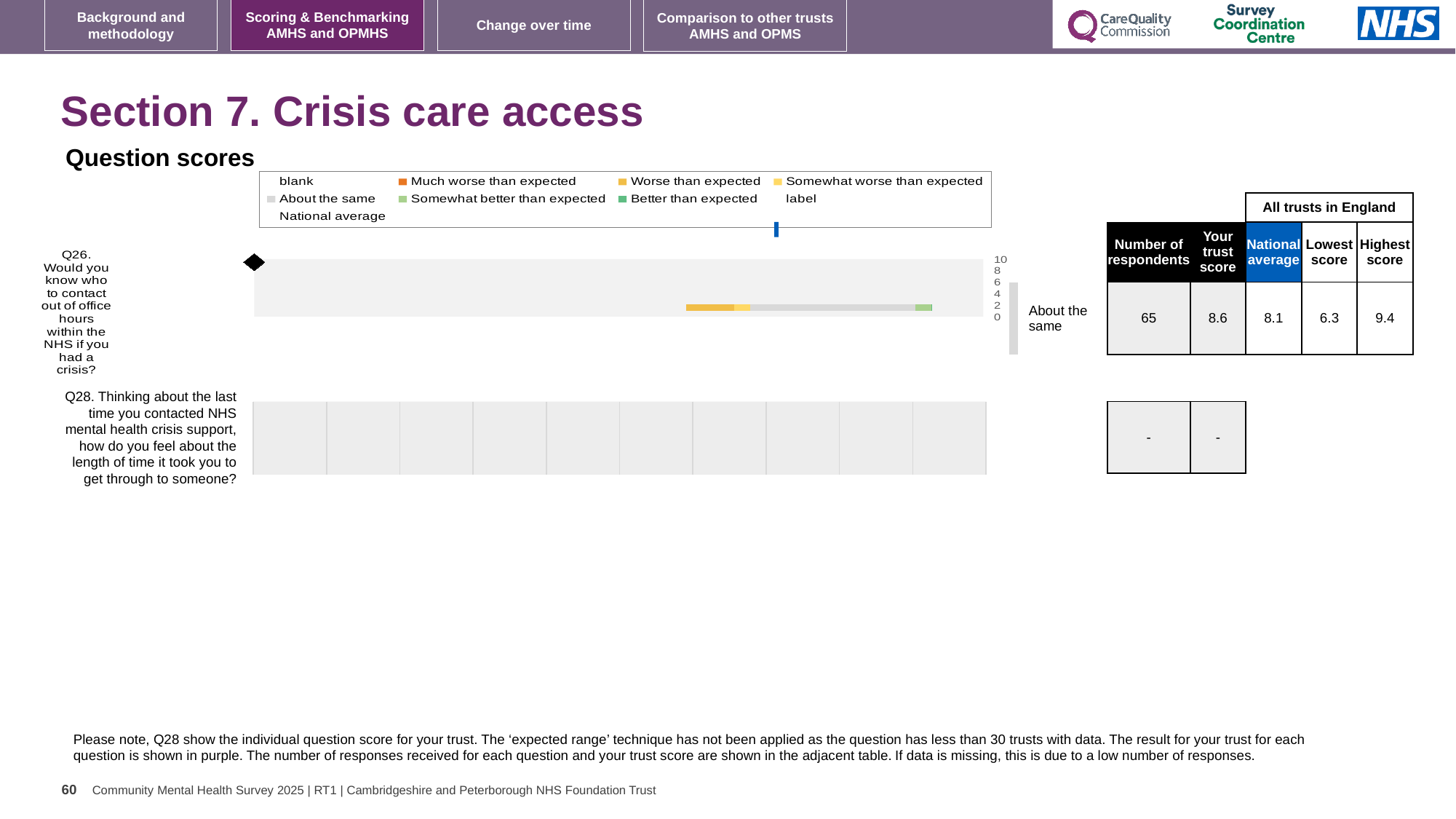
What is the trust score for Q26 (Would you know who to contact out of office hours within the NHS if you had a crisis?)? 8.6 For Q26, which is larger: the trust score or the national average? Trust score What is the highest score among all trusts in England for Q26? 9.4 How many questions are plotted in the Question scores chart? 2 What is the lowest score among all trusts in England for Q26? 6.3 What benchmark category label is shown next to the Q26 bar? About the same How many respondents are shown for Q26 in the table? 65 What is the difference between the highest and lowest trust scores for Q26? 3.1 What is shown in the table for the number of respondents and trust score for Q28? - What is the national average score for Q26? 8.1 By how much does the trust score for Q26 exceed the national average? 0.5 What kind of chart is used to show the question scores? Bar chart